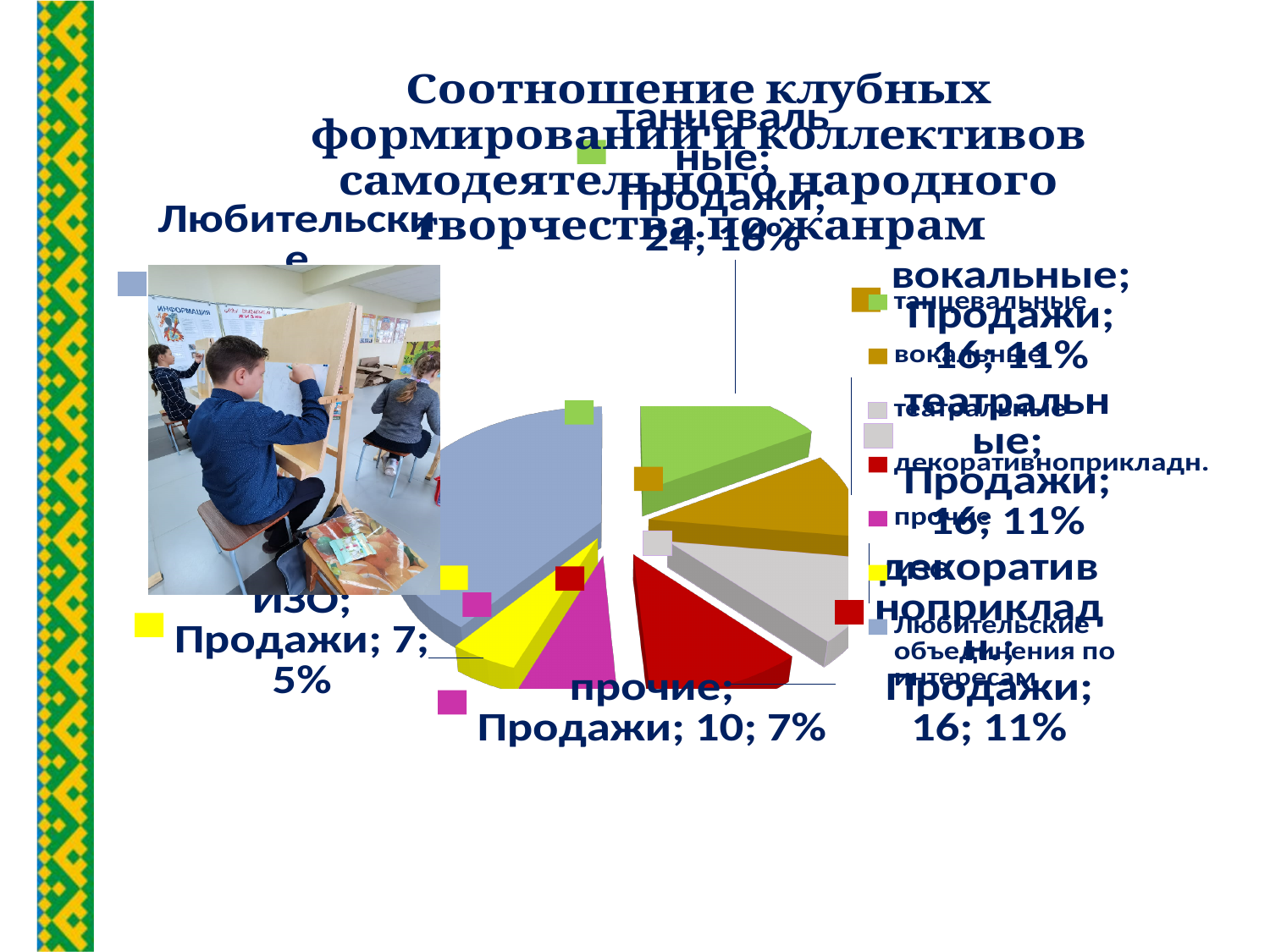
What kind of chart is shown on the slide? pie chart How many entries does the legend list? 7 What value is shown for the танцевальные slice? 24; 16% What colour is the танцевальные slice? green What percentage share does the вокальные slice have? 11% Which category has the largest slice in the pie chart? Любительские объединения по интересам Which is larger, the value for прочие or the value for ИЗО? прочие What value is shown for the прочие slice? 10; 7% What is the difference between the values for танцевальные and вокальные? 8 What value is shown for the ИЗО slice? 7; 5% What percentage share does the декоративноприкладн. slice have? 11% Which category has the smallest slice in the pie chart? ИЗО